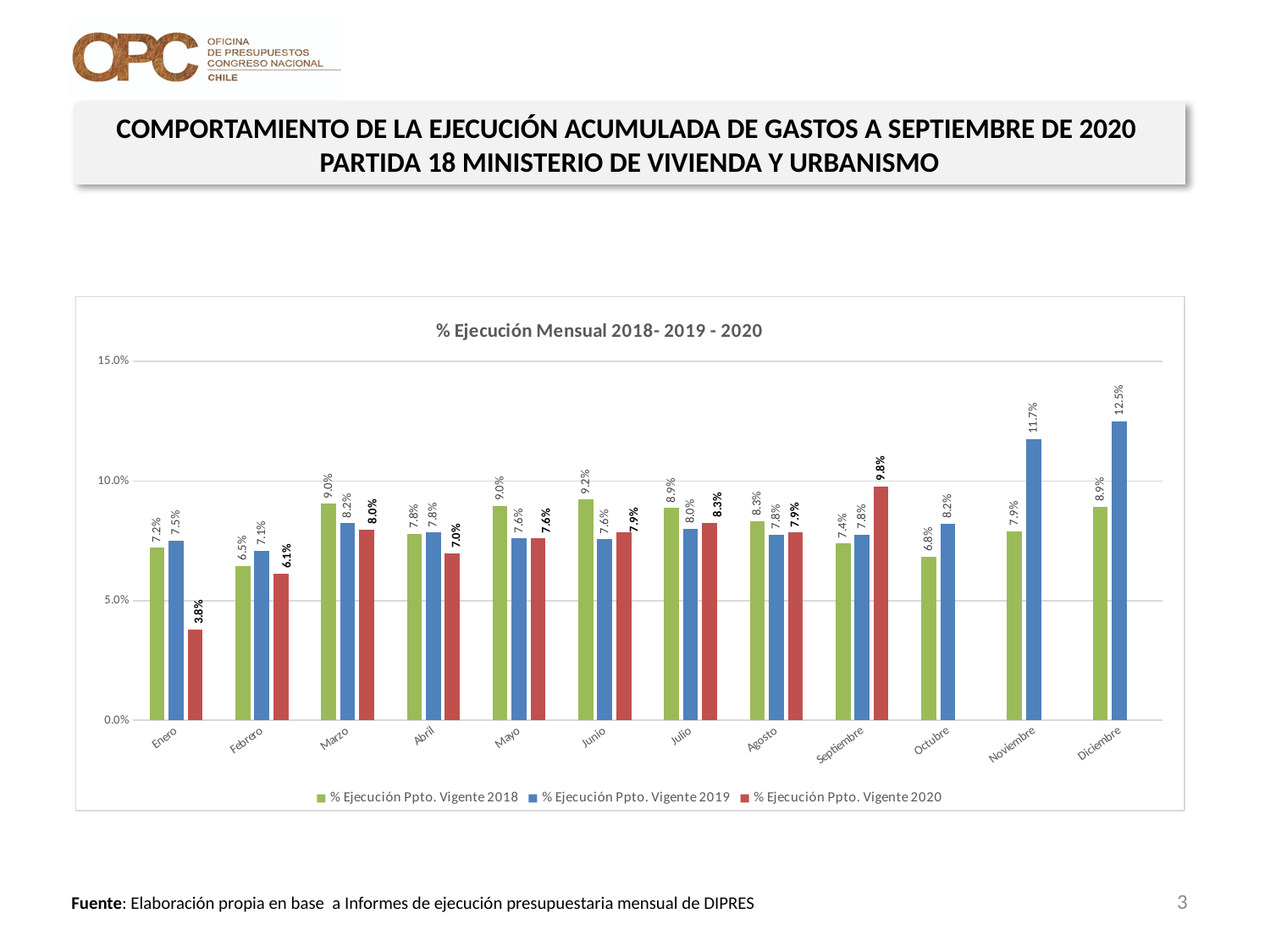
What is the value for % Ejecución Ppto. Vigente 2020 in Enero? 3.8% How many months are shown on the x axis? 12 What is the difference between the 2019 and 2018 values in Noviembre? 3.8% What is the value for % Ejecución Ppto. Vigente 2019 in Diciembre? 12.5% What is the value for % Ejecución Ppto. Vigente 2018 in Junio? 9.2% What is the title of the chart? % Ejecución Mensual 2018- 2019 - 2020 In Septiembre, which is larger: the 2020 value or the 2018 value? 2020 value What kind of chart is shown? Bar chart Is the value for % Ejecución Ppto. Vigente 2019 in Noviembre greater or less than 10.0%? greater Which month has the lowest value for % Ejecución Ppto. Vigente 2018? Febrero Which month has the highest value for % Ejecución Ppto. Vigente 2020? Septiembre How many series does the legend list? 3